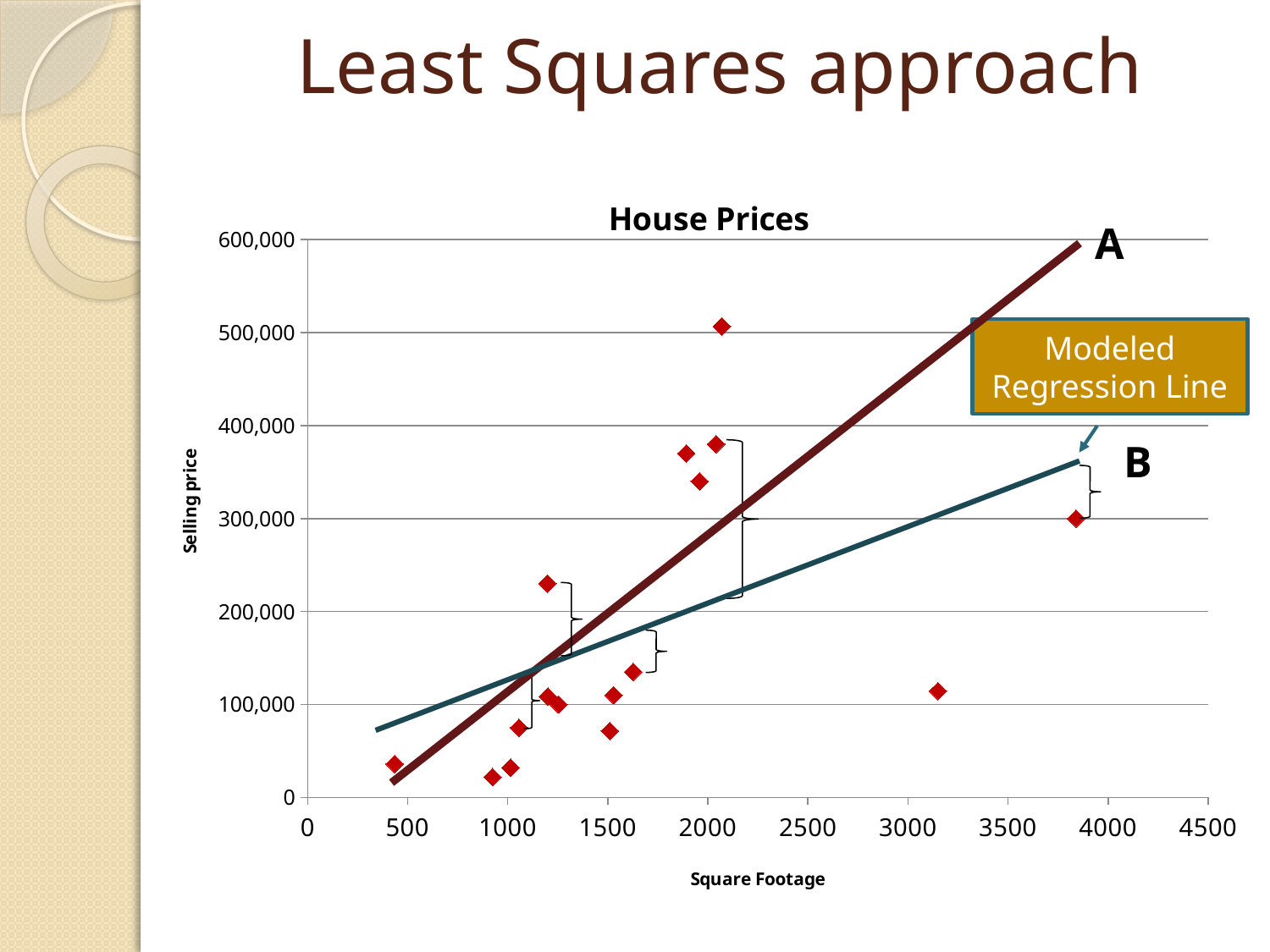
Is the lowest plotted selling price greater or less than 100,000? less What is the title of the chart? House Prices Which of the two lines, A or B, is steeper? A What kind of chart is shown on the slide? Scatter chart Is the selling price of the point at roughly 3150 square feet greater or less than 200,000? less Which line does the callout 'Modeled Regression Line' point to? B What is the maximum value shown on the y axis? 600,000 Do selling prices generally rise or fall as square footage increases? rise Is the selling price of the house with the largest square footage (around 3850) greater or less than 400,000? less